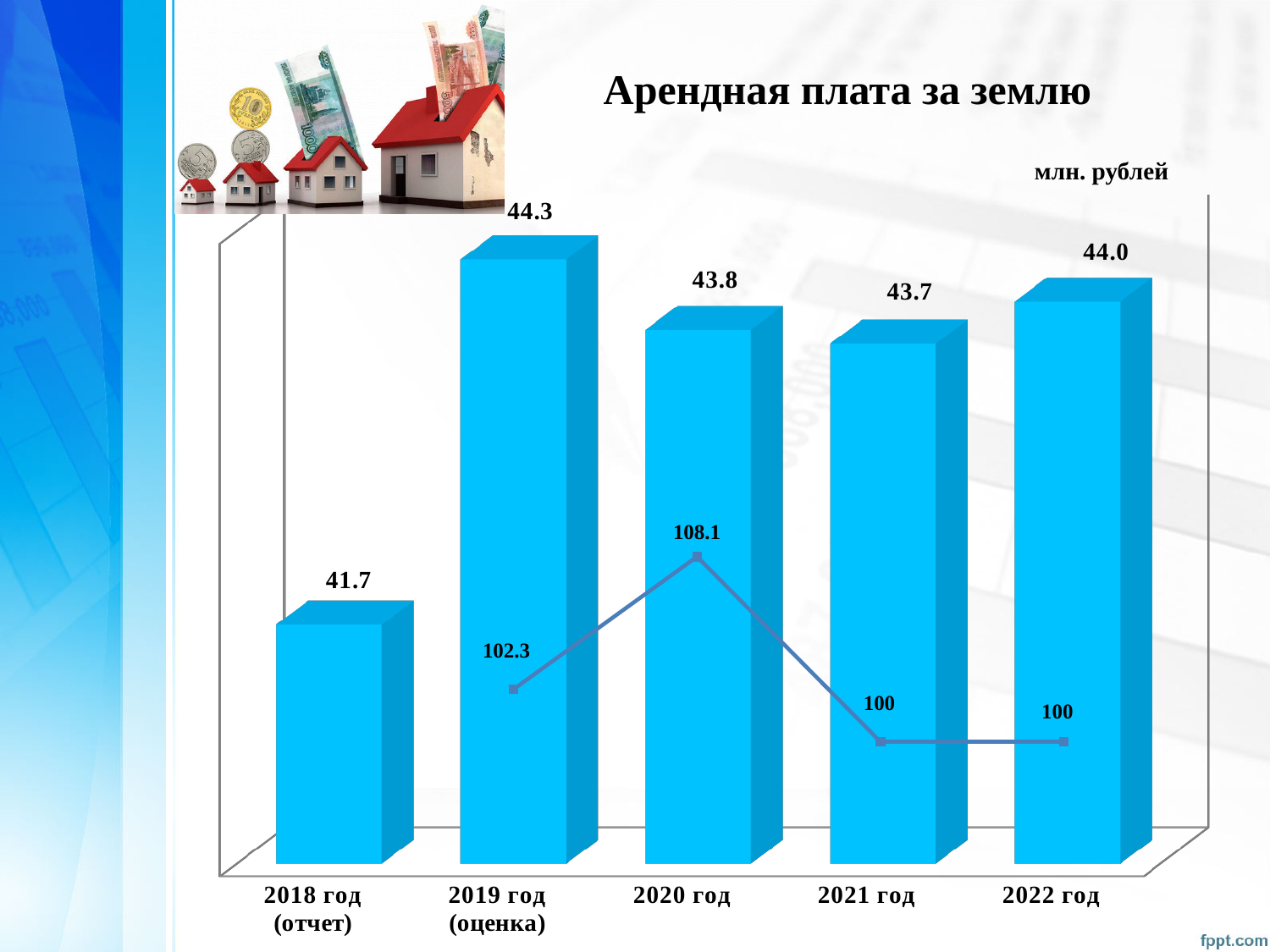
What is the value of the bar for 2018 год (отчет)? 41.7 How many years are shown on the x axis? 5 What is the value of the bar for 2022 год? 44.0 What is the value of the line point for 2020 год? 108.1 What is the title of the chart? Арендная плата за землю What is the difference between the bar values for 2019 год (оценка) and 2018 год (отчет)? 2.6 What unit is stated for the bar values on the chart? млн. рублей Which year has the lowest bar value? 2018 год (отчет) Which is larger, the bar value for 2020 год or for 2022 год? 2022 год What is the value of the line point for 2021 год? 100 Which year has the highest bar value? 2019 год (оценка) What is the value of the bar for 2019 год (оценка)? 44.3